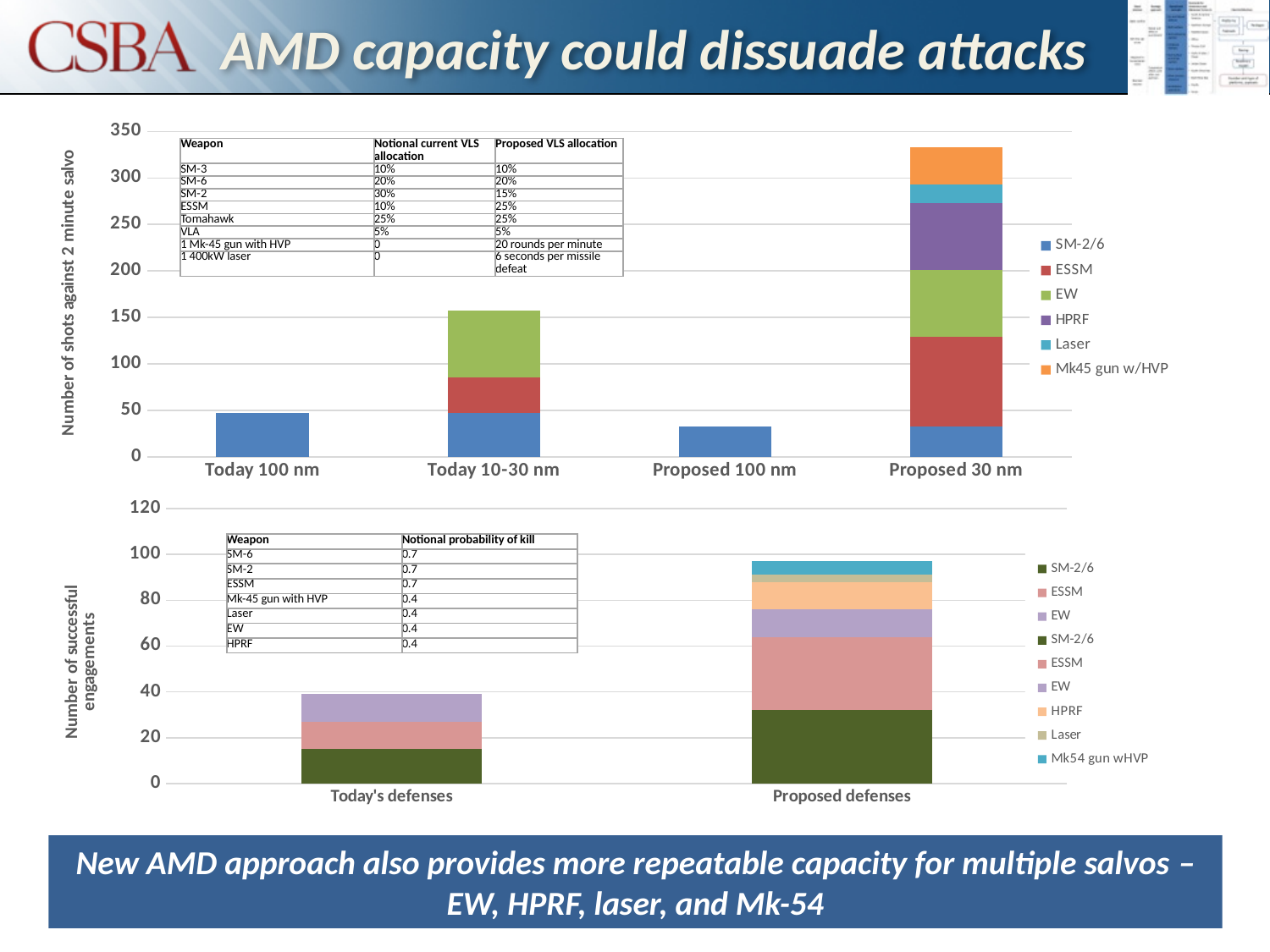
In the top chart (Number of shots against 2 minute salvo), is the total for Proposed 30 nm greater or less than 300? greater In the top chart (Number of shots against 2 minute salvo), how many categories are shown on the x axis? 4 In the top chart (Number of shots against 2 minute salvo), how many series does the legend list? 6 In the top chart (Number of shots against 2 minute salvo), what kind of chart is shown? Stacked bar chart In the top chart (Number of shots against 2 minute salvo), which has the larger total: Today 100 nm or Today 10-30 nm? Today 10-30 nm In the bottom chart (Number of successful engagements), is the total for Today's defenses greater or less than 60? less In the top chart (Number of shots against 2 minute salvo), is the total for Proposed 100 nm greater or less than 50? less In the bottom chart (Number of successful engagements), how many categories are shown on the x axis? 2 In the bottom chart (Number of successful engagements), how many entries does the legend list? 9 In the top chart (Number of shots against 2 minute salvo), which category has the tallest stacked bar? Proposed 30 nm In the top chart (Number of shots against 2 minute salvo), which category has the shortest stacked bar? Proposed 100 nm